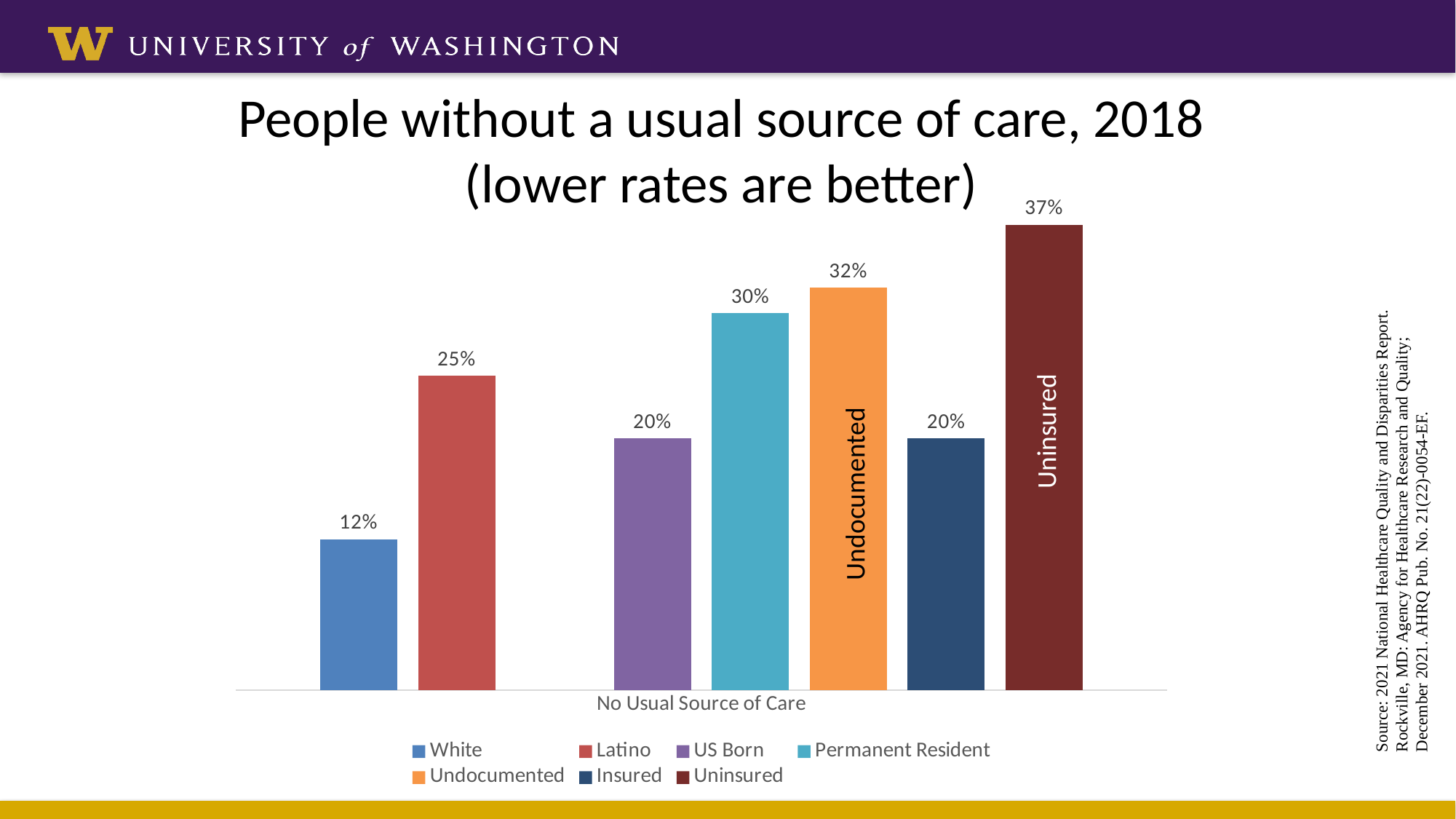
Which is larger, the value for Undocumented or the value for Permanent Resident? Undocumented How many series does the legend list? 7 What is the value for Latino? 25% What kind of chart is shown on the slide? Bar chart What is the value for White? 12% What is the value for Undocumented? 32% What is the difference between the Uninsured and Insured values? 17% What is the value for Permanent Resident? 30% Which series has the highest value? Uninsured What is the title of the chart? People without a usual source of care, 2018 (lower rates are better) What is the difference between the Latino and White values? 13% Which series has the lowest value? White